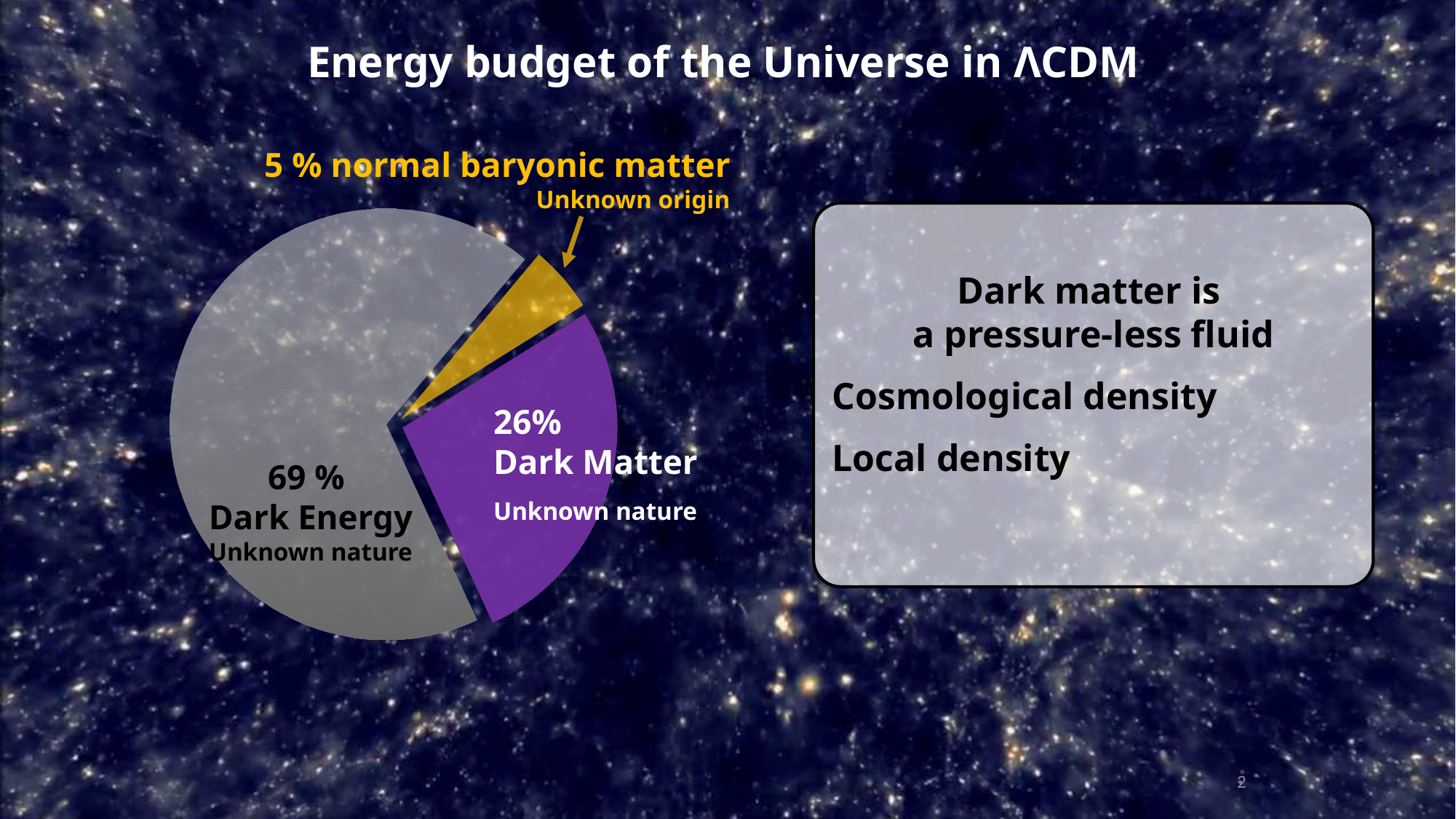
Which slice of the pie chart is the smallest? normal baryonic matter What share of the energy budget is normal baryonic matter? 5 % What colour is the Dark Matter slice of the pie chart? purple What is the title of the slide containing the pie chart? Energy budget of the Universe in ΛCDM What kind of chart is shown on the slide? pie chart How many slices does the pie chart have? 3 What share of the energy budget is Dark Matter? 26% What is the difference in percentage points between Dark Matter and normal baryonic matter? 21 What share of the energy budget is Dark Energy? 69 % What is the difference in percentage points between Dark Energy and Dark Matter? 43 Which slice of the pie chart is the largest? Dark Energy Which is larger, the Dark Matter slice or the Dark Energy slice? Dark Energy